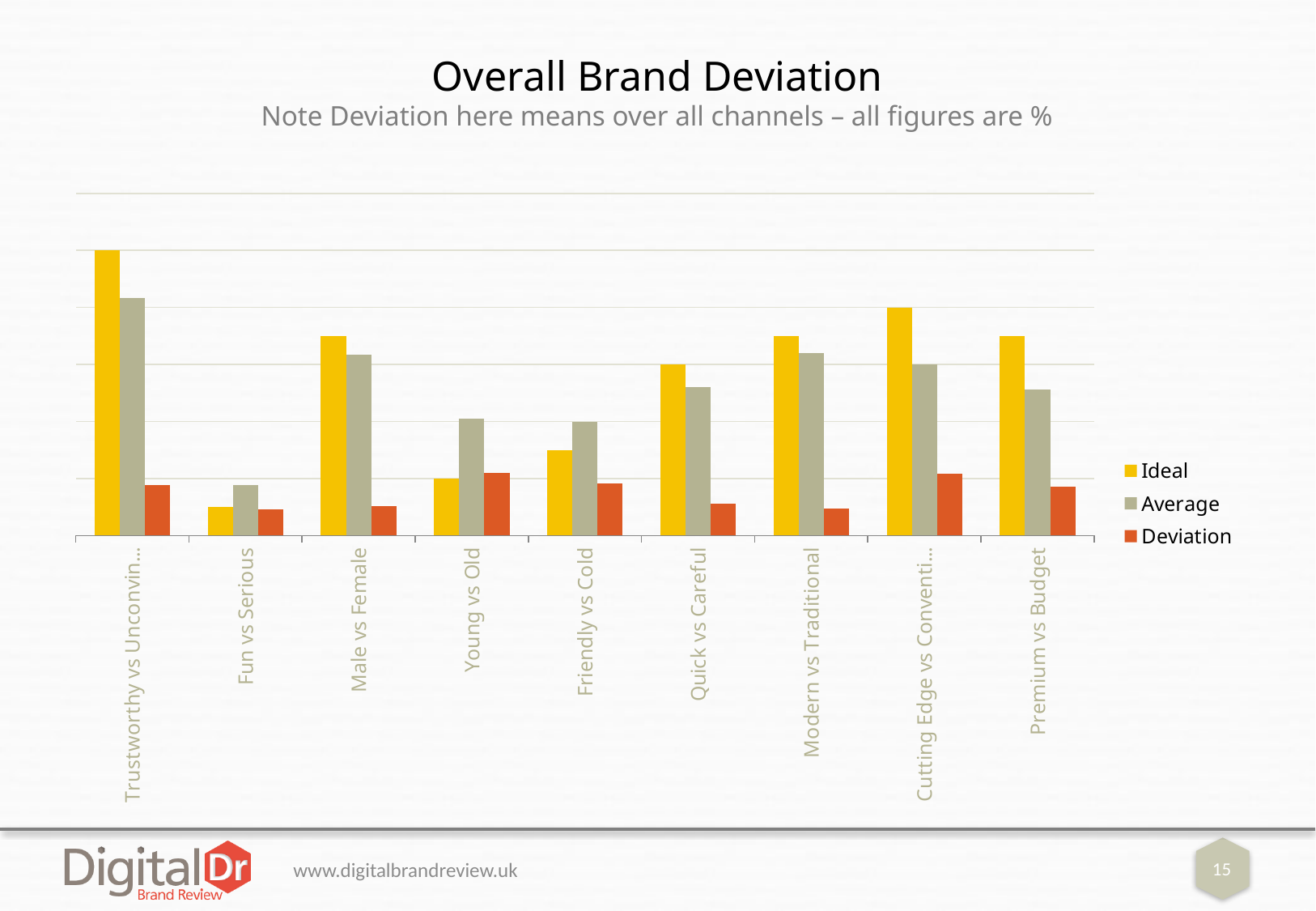
For Young vs Old, which is larger, the Ideal value or the Average value? Average How many categories are plotted along the x axis? 9 For Friendly vs Cold, which is larger, the Ideal value or the Average value? Average For Male vs Female, which is larger, the Ideal value or the Average value? Ideal What kind of chart is shown on the slide? Bar chart Which category has the lowest Average value? Fun vs Serious What are the three series named in the legend? Ideal, Average, Deviation Which category has the lowest Ideal value? Fun vs Serious What is the title of the chart? Overall Brand Deviation How many series does the legend list? 3